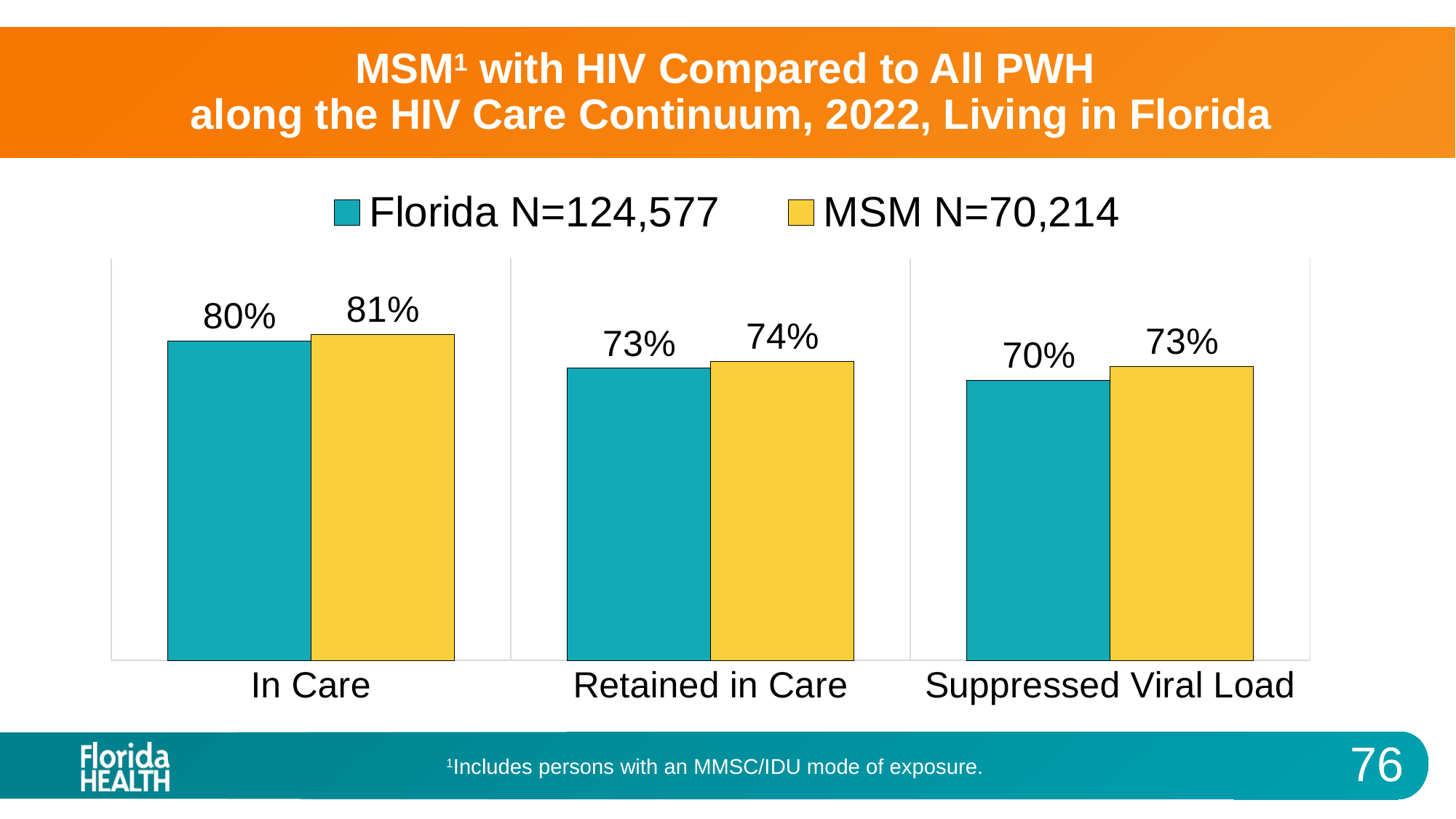
What kind of chart is shown on the slide? Bar chart Which category has the lowest value for Florida N=124,577? Suppressed Viral Load What is the value for Florida N=124,577 in the Retained in Care category? 73% How many series does the legend list? 2 How many categories are shown on the x axis? 3 What is the value for MSM N=70,214 in the Suppressed Viral Load category? 73% What is the value for MSM N=70,214 in the Retained in Care category? 74% What is the value for Florida N=124,577 in the In Care category? 80% Do the Florida N=124,577 values rise or fall from In Care to Suppressed Viral Load? Fall What is the difference between the Florida N=124,577 values for In Care and Suppressed Viral Load? 10% Which category has the highest value for MSM N=70,214? In Care What is the difference between the MSM N=70,214 and Florida N=124,577 values for Suppressed Viral Load? 3%